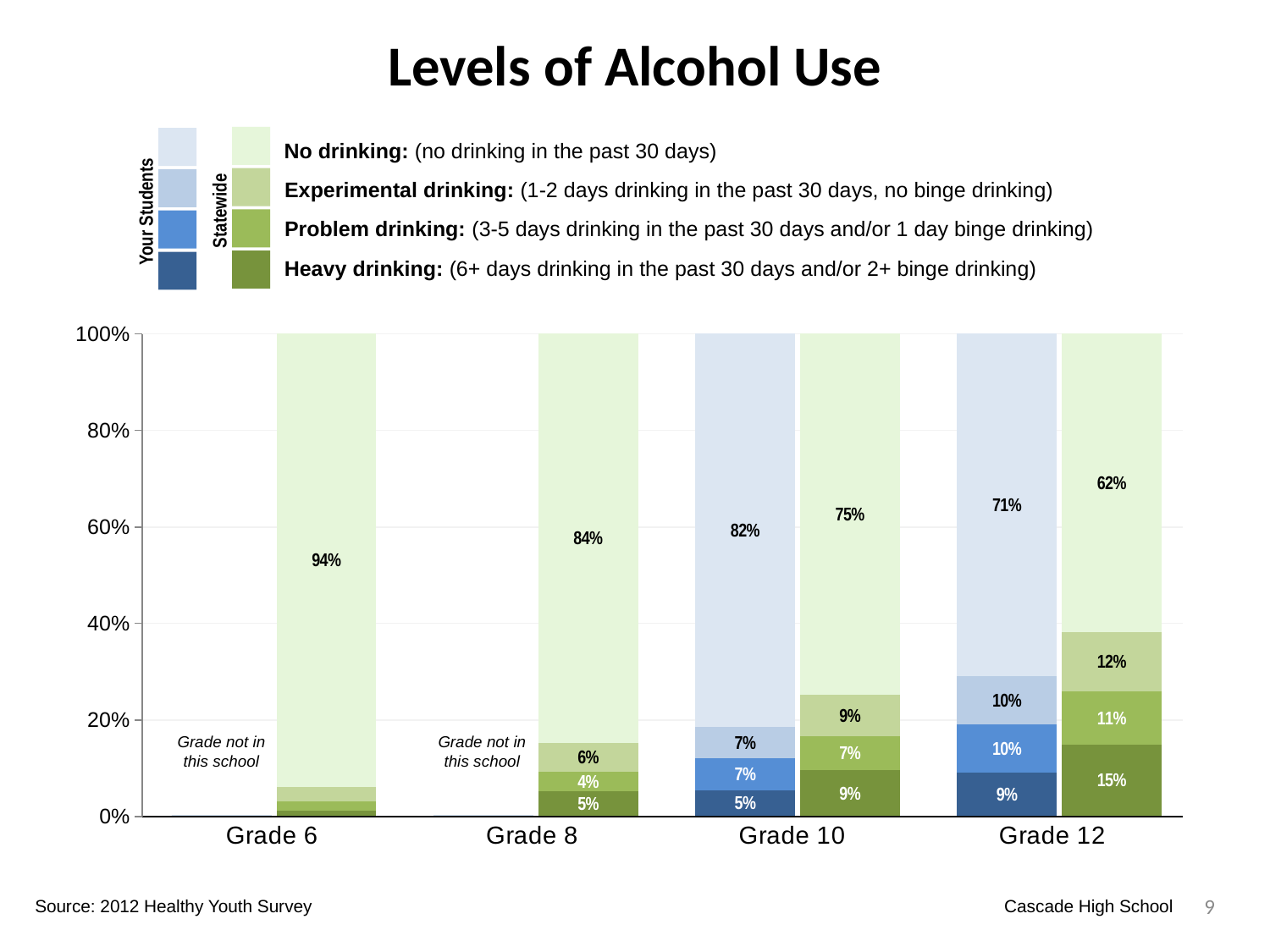
What is the Statewide percentage for Experimental drinking in Grade 8? 6% What is the Your Students percentage for No drinking in Grade 12? 71% What kind of chart is shown on the slide? Stacked bar chart What is the Statewide percentage for No drinking in Grade 6? 94% What is the Your Students percentage for Heavy drinking in Grade 10? 5% How many grades are shown on the x axis? 4 In Grade 12, how many percentage points higher is the Your Students No drinking value than the Statewide No drinking value? 9 percentage points In Grade 10, which group has the higher No drinking percentage, Your Students or Statewide? Your Students What is the Statewide percentage for Heavy drinking in Grade 12? 15% Does the Statewide No drinking percentage rise or fall from Grade 6 to Grade 12? Fall Which grade has the highest Statewide No drinking percentage? Grade 6 Which grades are marked "Grade not in this school" for Your Students? Grade 6 and Grade 8